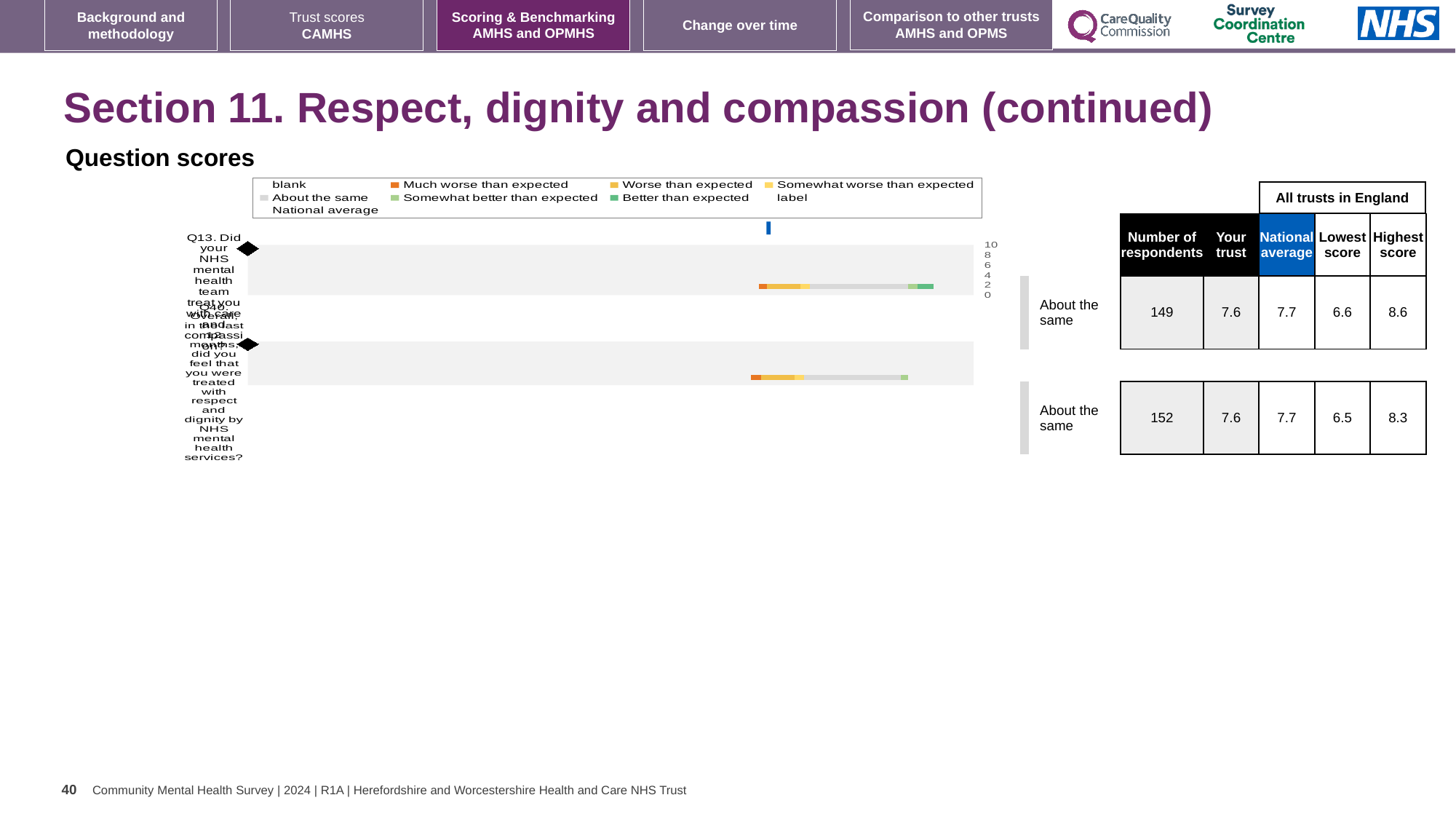
What benchmark category is shown beside the second question bar? About the same How many question bars are plotted in the chart? 2 In the table beside the chart, what is the number of respondents for the second question row? 152 In the table beside the chart, what is the national average for the second question row? 7.7 What kind of chart is shown under 'Question scores'? bar chart In the table beside the chart, which row has the larger highest score, the first (8.6) or the second (8.3)? the first row In the table beside the chart, what is 'Your trust' score for the first question row? 7.6 What is the highest value shown on the chart's axis? 10 What colour does the legend use for 'Much worse than expected'? orange In the table beside the chart, what is the number of respondents for the first question row? 149 What benchmark category is shown beside the first question bar? About the same In the table beside the chart, what is the lowest score for the second question row? 6.5